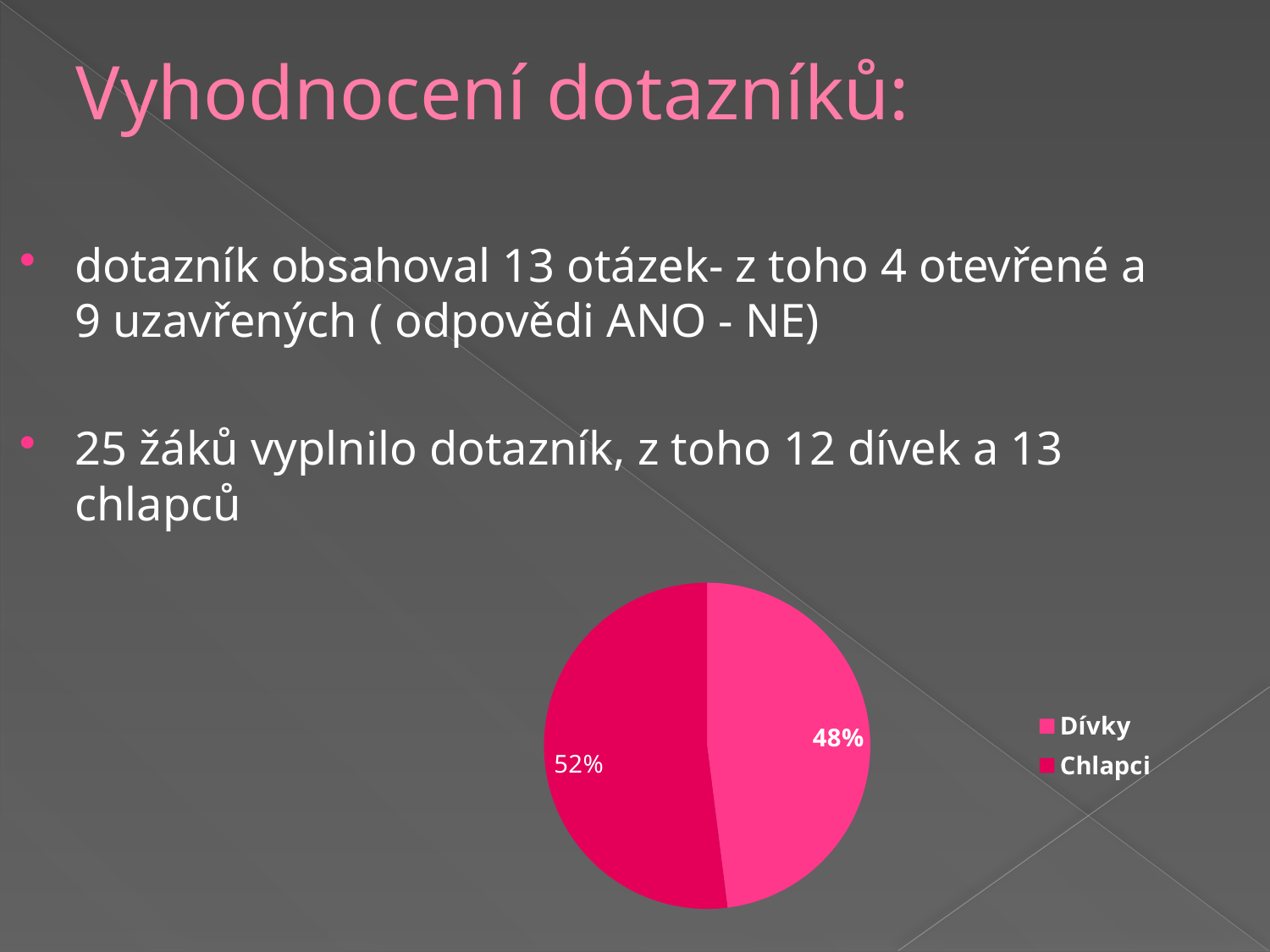
What kind of chart is shown on the slide? pie chart Which is larger, the Dívky slice or the Chlapci slice? Chlapci What share of the pie does Dívky represent? 48% Is the share for Dívky greater or less than 50%? less How many entries does the legend list? 2 What is the difference in percentage points between the Chlapci and Dívky slices? 4% How many slices does the pie chart have? 2 What are the two legend entries of the pie chart? Dívky, Chlapci Which slice of the pie is the largest? Chlapci Which slice of the pie is the smallest? Dívky What share of the pie does Chlapci represent? 52%